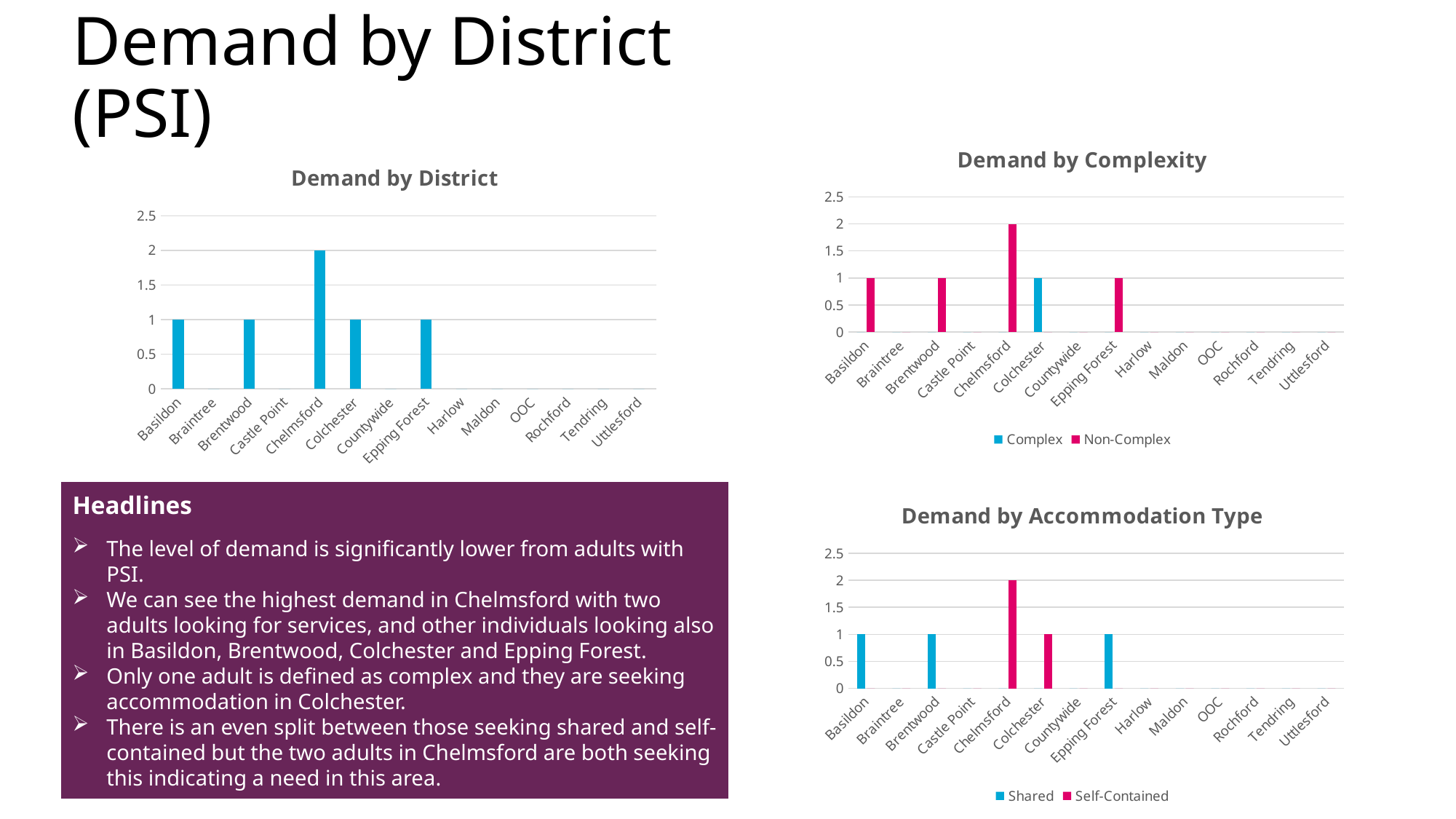
In the 'Demand by District' chart, what is the value for Chelmsford? 2 In the 'Demand by District' chart, which district has the highest demand? Chelmsford What kind of chart is 'Demand by District'? Bar chart In the 'Demand by Accommodation Type' chart, what is the Shared value for Epping Forest? 1 In the 'Demand by Accommodation Type' chart, what is the Self-Contained value for Chelmsford? 2 In the 'Demand by Complexity' chart, what is the Non-Complex value for Chelmsford? 2 In the 'Demand by District' chart, what is the difference between the values for Chelmsford and Basildon? 1 In the 'Demand by Complexity' chart, which district has a Complex bar? Colchester In the 'Demand by Accommodation Type' chart, which is larger: the Shared value for Basildon or the Self-Contained value for Chelmsford? Self-Contained value for Chelmsford In the 'Demand by Complexity' chart, how many series does the legend list? 2 In the 'Demand by Accommodation Type' chart, what are the two series listed in the legend? Shared and Self-Contained In the 'Demand by District' chart, how many districts are listed on the x axis? 14